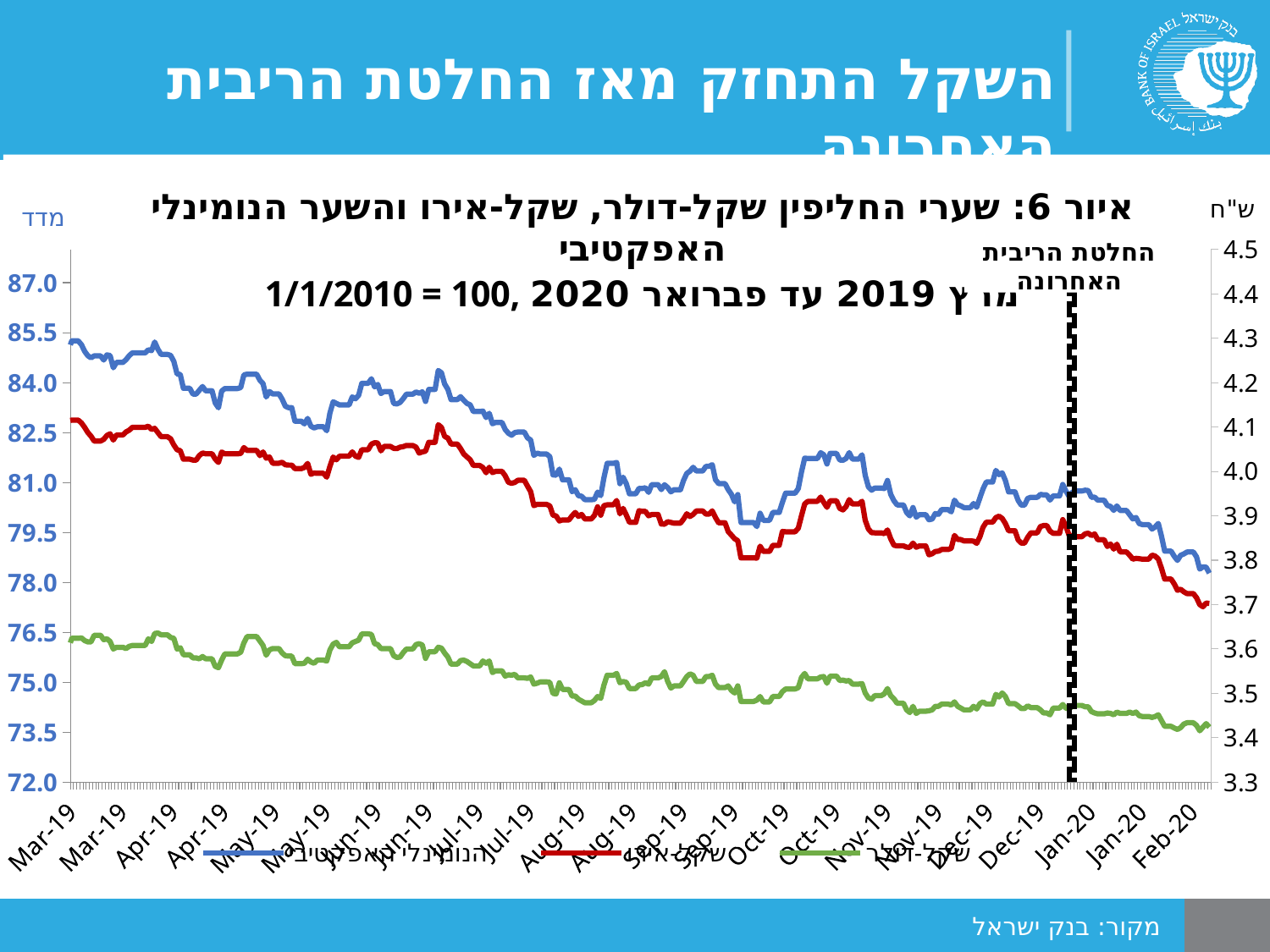
What is the highest tick value shown on the right-hand axis of the chart? 4.5 How many series are plotted in the chart? 3 What kind of chart is shown on the slide? line chart Which line is the highest on the chart throughout the period: the blue, red or green line? blue On the left axis, is the value of the blue line at the start of the period (Mar-19) greater or less than 84.0? greater On the left axis, is the value of the blue line at the end of the period (Feb-20) greater or less than 79.5? less Which line is the lowest on the chart throughout the period: the blue, red or green line? green Do the plotted lines generally rise or fall from Mar-19 to Feb-20? fall What does the dashed vertical line on the chart mark, according to its label? החלטת הריבית האחרונה At Mar-19, which line has the larger value: the blue line or the green line? blue